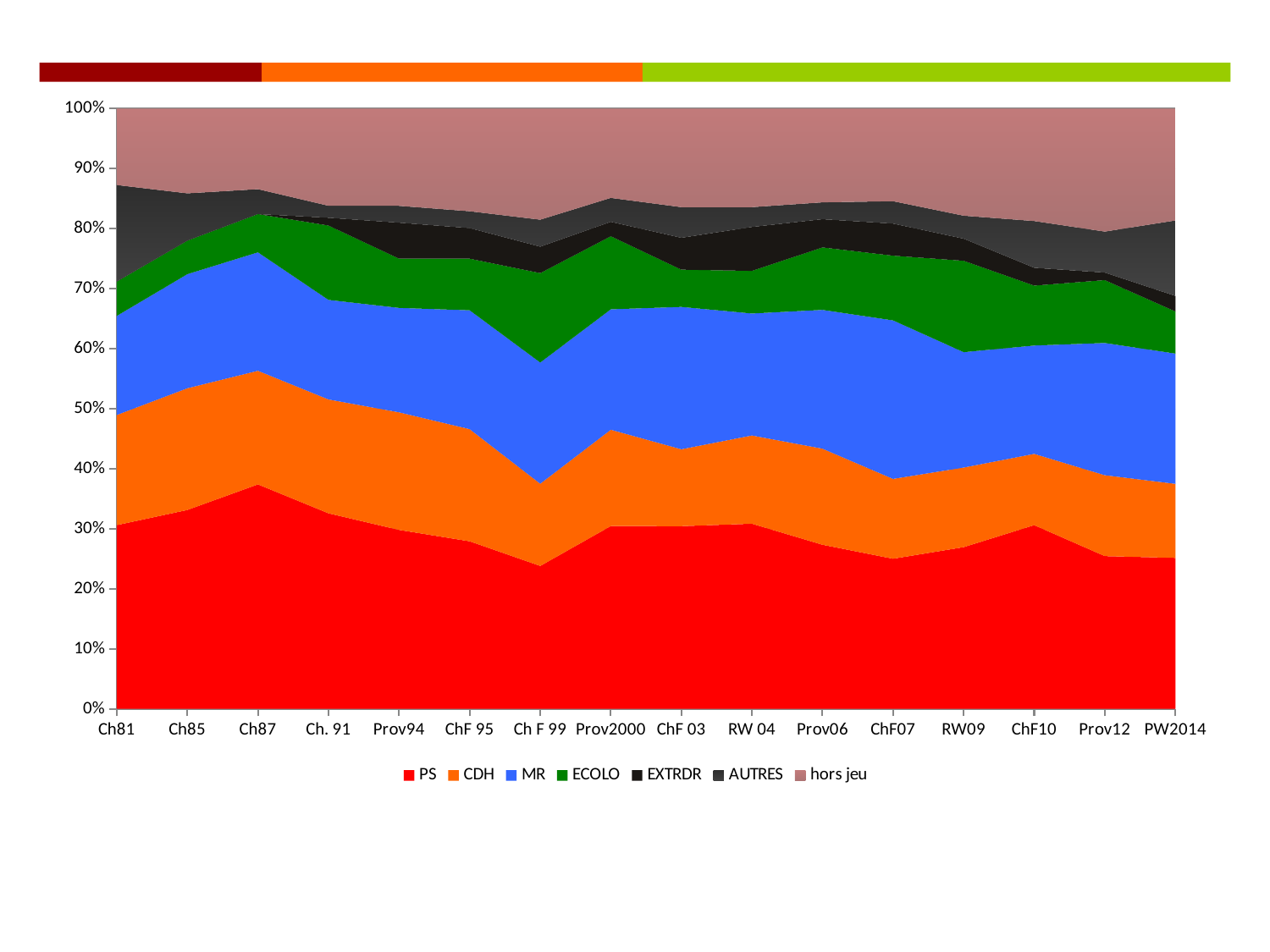
At which election does the PS series reach its highest share? Ch87 How many election categories are shown along the x axis? 16 Which series is plotted at the top of the stack, just below 100%? hors jeu Is the PS share at Ch F 99 greater or less than 30%? less Which series is plotted at the bottom of the stack? PS Is the PS share at Ch87 greater or less than 30%? greater How many series does the legend list? 7 Which is larger: the PS share at Ch87 or the PS share at Ch F 99? Ch87 What is the first category on the x axis? Ch81 What kind of chart is shown on the slide? Stacked area chart Is the PS share at PW2014 greater or less than 30%? less Does the PS share rise or fall from Ch87 to Ch F 99? fall